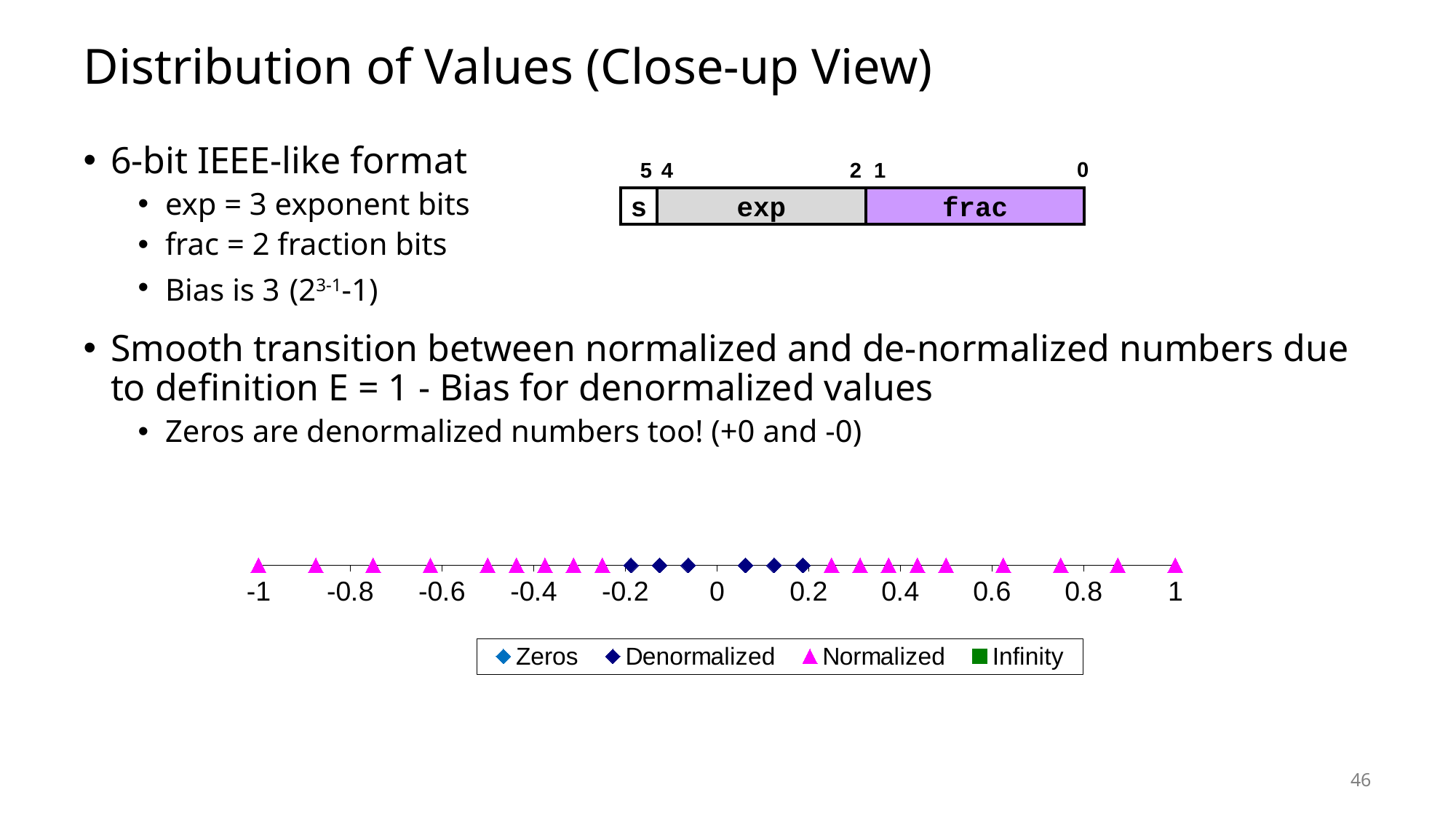
What marker shape is used for the Normalized series in the chart? triangle How many Normalized points are plotted on the chart? 18 Do the Normalized points on the chart get closer together or farther apart as they approach 0? closer together What are the four series named in the chart legend? Zeros, Denormalized, Normalized, Infinity How many Denormalized points are plotted on the chart? 6 How many series does the chart legend list? 4 Is the largest Normalized point on the chart greater or less than 0.8? greater How many tick labels are shown on the chart's x axis? 11 Are all the Denormalized points on the chart plotted between -0.2 and 0.2? yes What is the lowest value labelled on the chart's x axis? -1 What is the highest value labelled on the chart's x axis? 1 What kind of chart is shown at the bottom of the slide? scatter chart